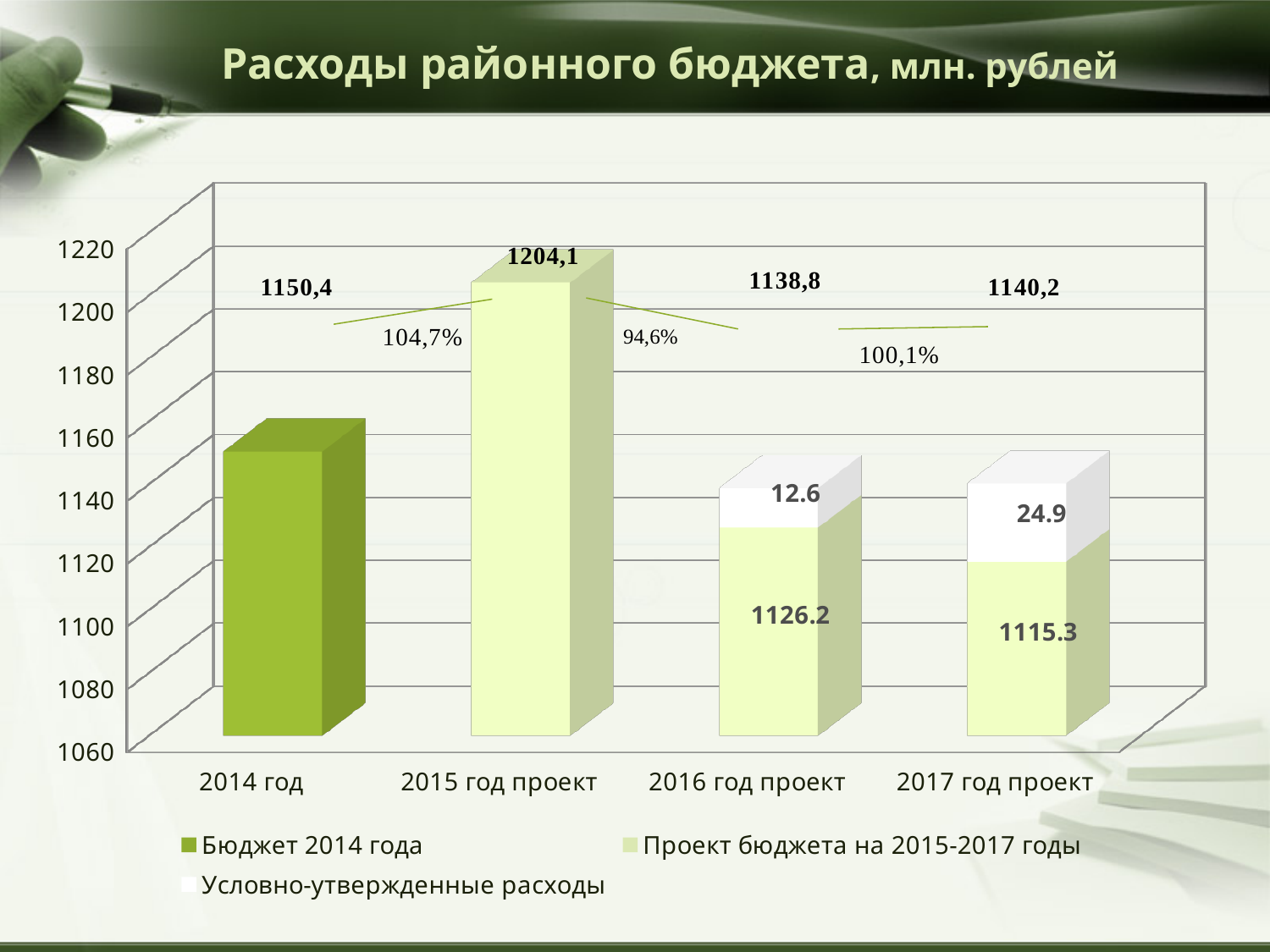
What kind of chart is shown on the slide? Bar chart What is the value of the bar for 2014 год? 1150,4 Which category has the highest total value? 2015 год проект Which is larger: the total for 2014 год or the total for 2015 год проект? 2015 год проект How many series does the legend list? 3 What is the difference between the total for 2015 год проект and the value for 2014 год? 53,7 What is the value of the Проект бюджета на 2015-2017 годы segment for 2016 год проект? 1126.2 What is the total of the stacked bar for 2017 год проект? 1140,2 Which category has the lowest total value according to the labels? 2016 год проект How many categories are shown on the x axis? 4 What is the total value shown for 2015 год проект? 1204,1 What is the value of the Условно-утвержденные расходы segment for 2017 год проект? 24.9